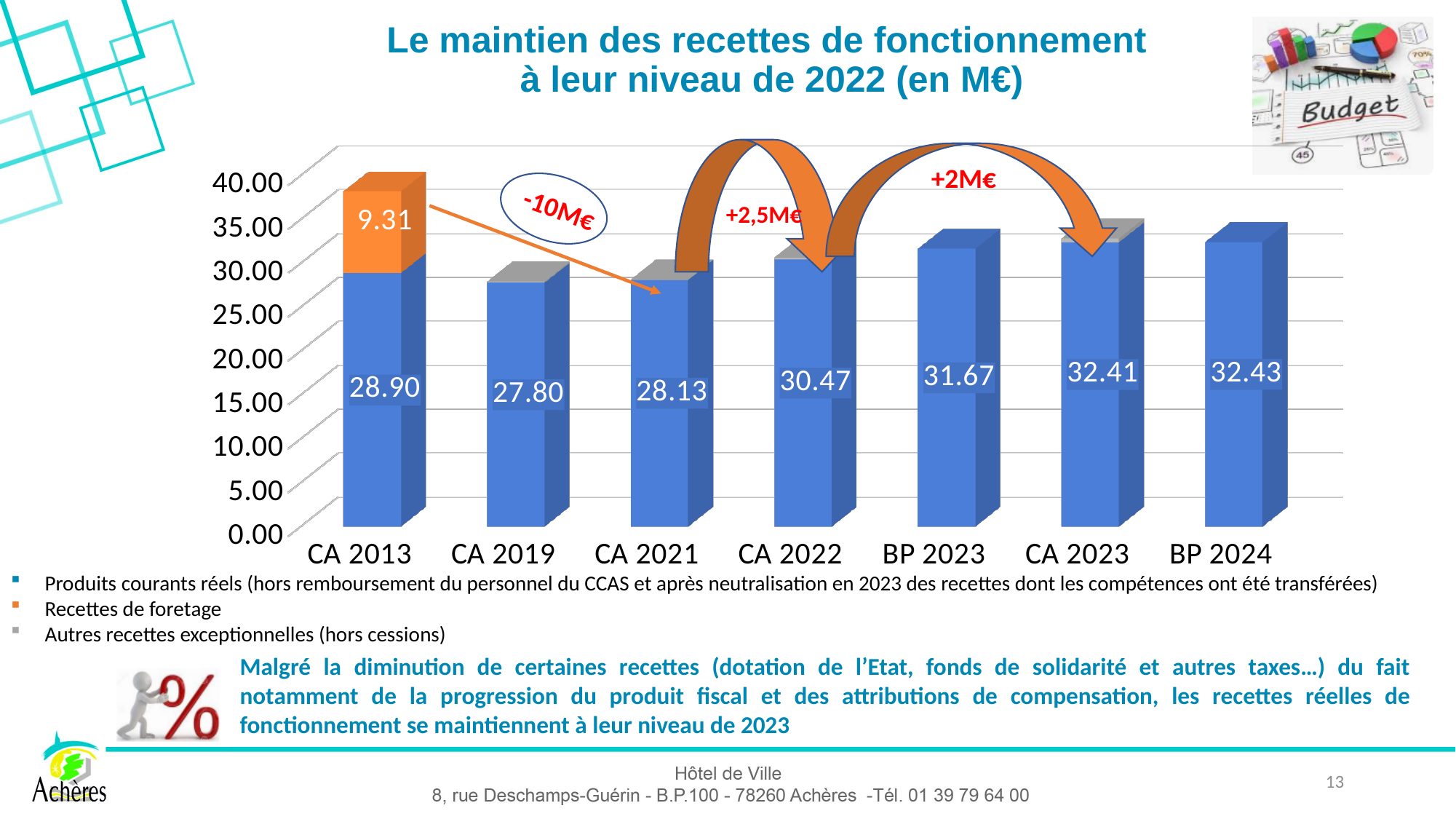
Which category has the lowest value for Produits courants réels? CA 2019 What kind of chart is shown on the slide? bar chart What is the value of Produits courants réels for CA 2022? 30.47 What is the difference between the Produits courants réels values for CA 2022 and CA 2021? 2.34 How many series does the legend list? 3 What is the value of Produits courants réels for BP 2024? 32.43 How many categories are shown on the x axis? 7 Which is larger for Produits courants réels: CA 2013 or CA 2021? CA 2013 Is the Produits courants réels value for CA 2019 greater or less than 30.00? less What is the value of Recettes de foretage for CA 2013? 9.31 What is the total of the labelled segments of the CA 2013 bar? 38.21 What colour represents Recettes de foretage in the chart? orange